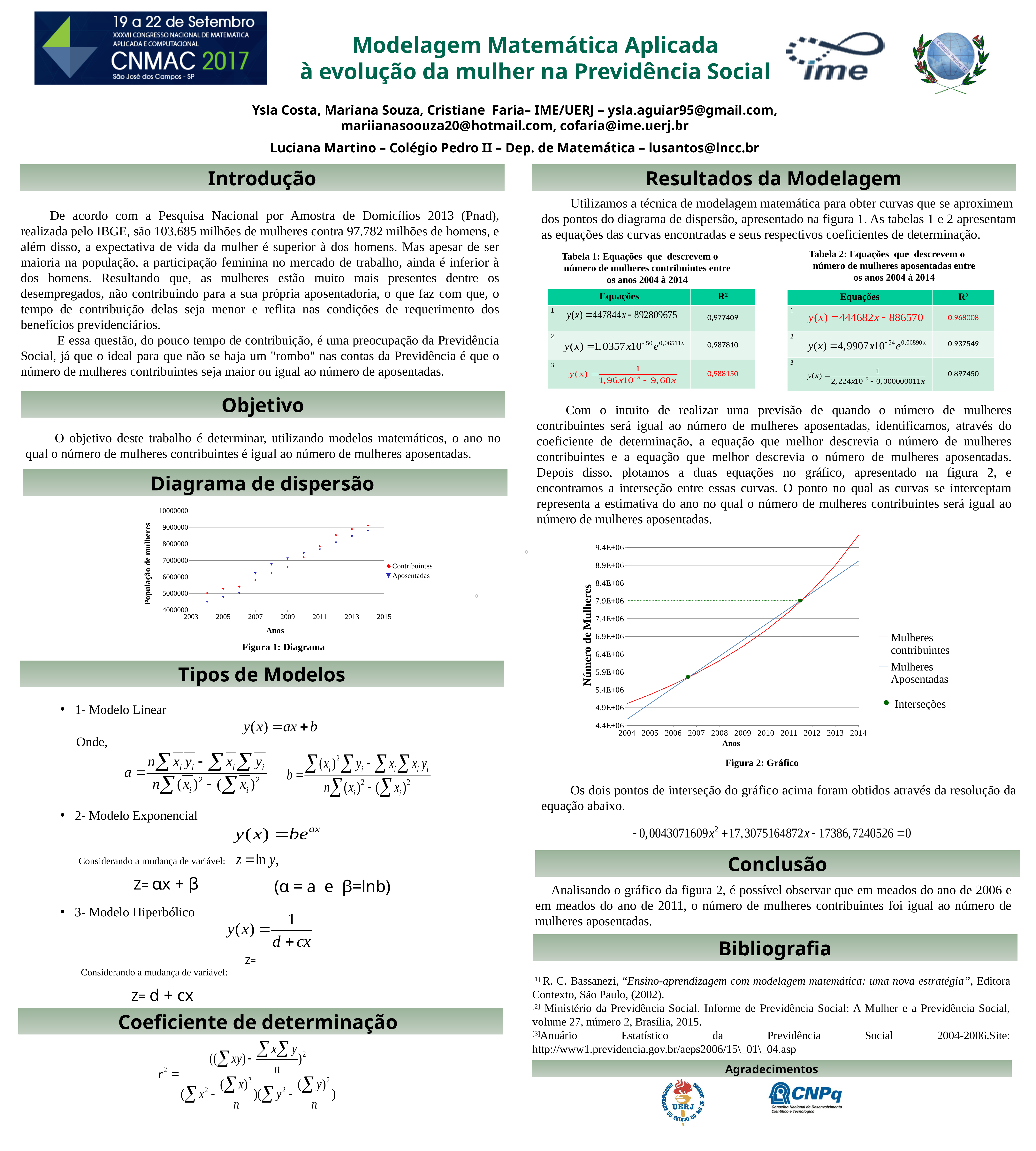
In Figura 2: Gráfico, how many intersection points (Interseções) are plotted? 2 In Figura 1: Diagrama, is the Contribuintes value for 2009 greater or less than 7000000? less In Figura 2: Gráfico, which series is higher in 2014, Mulheres contribuintes or Mulheres Aposentadas? Mulheres contribuintes In Figura 1: Diagrama, do the Contribuintes values rise or fall from 2004 to 2014? rise What kind of chart is Figura 1: Diagrama? scatter chart In Figura 1: Diagrama, is the Aposentadas value for 2014 greater or less than 9000000? less In Figura 1: Diagrama, is the Aposentadas value for 2004 greater or less than 5000000? less What kind of chart is Figura 2: Gráfico? line chart How many entries does the legend of Figura 2: Gráfico list? 3 In Figura 1: Diagrama, what are the two series named in the legend? Contribuintes and Aposentadas How many series does the legend of Figura 1: Diagrama list? 2